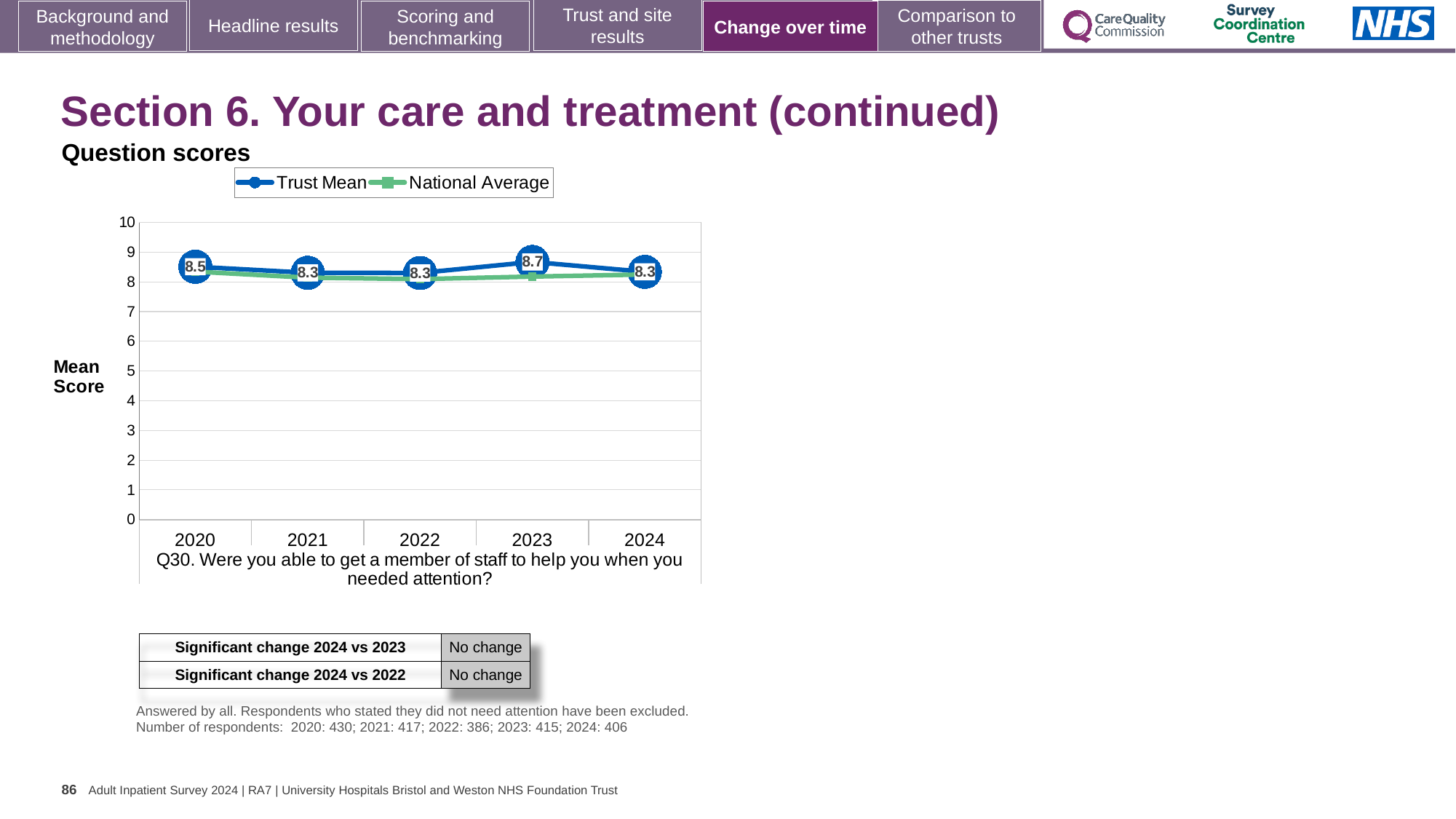
Is the National Average value for 2020 greater or less than 7? greater What is the Trust Mean score for 2020? 8.5 How many years are shown on the x axis of the chart? 5 In which year is the Trust Mean score highest? 2023 What is the Trust Mean score for 2024? 8.3 What are the two series named in the chart legend? Trust Mean and National Average What is the difference between the Trust Mean scores for 2023 and 2024? 0.4 Does the Trust Mean score rise or fall from 2023 to 2024? Fall What kind of chart is shown on the slide? Line chart What is the Trust Mean score for 2023? 8.7 How many series does the chart legend list? 2 Which year has the larger Trust Mean score, 2020 or 2023? 2023